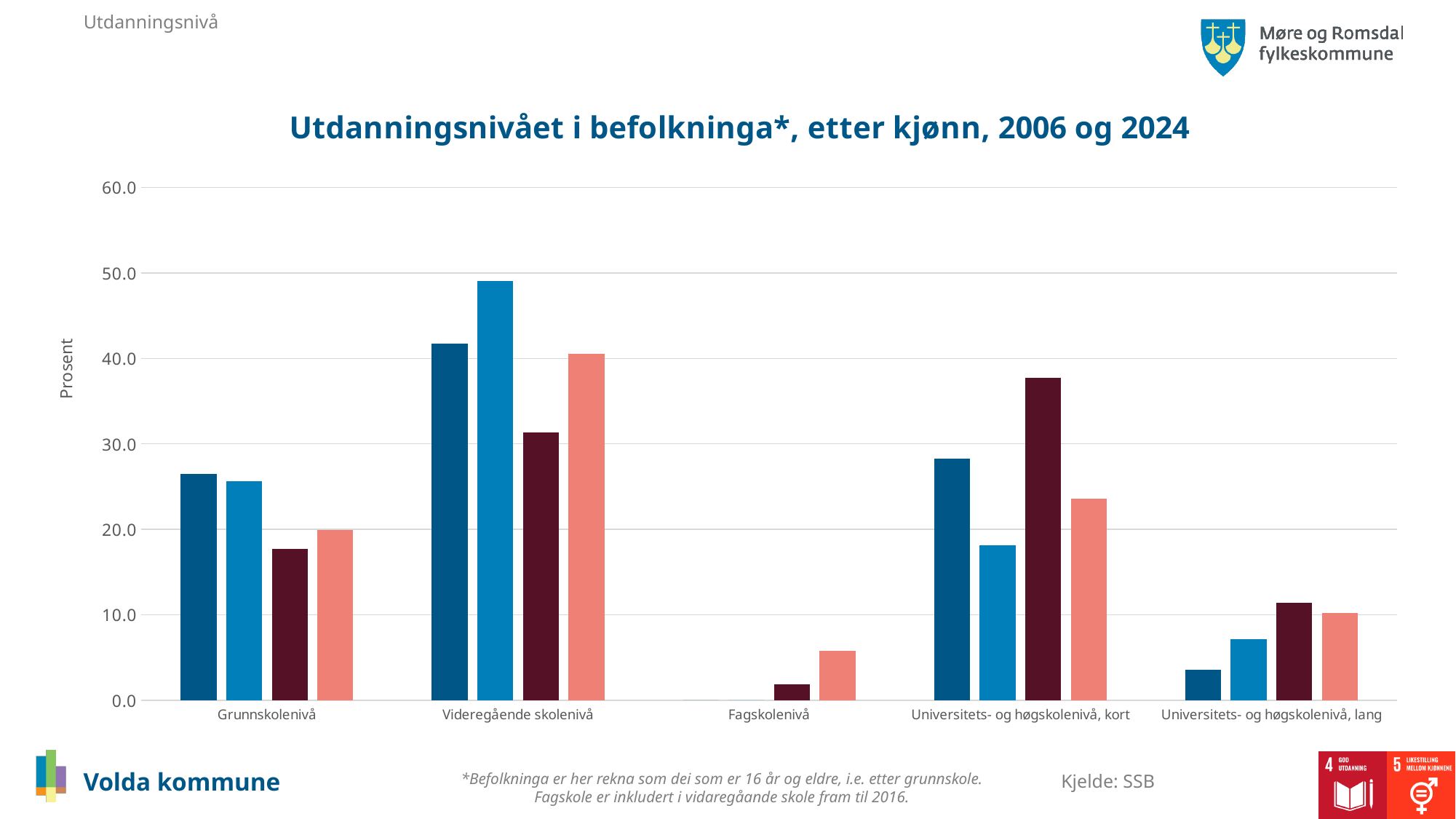
What kind of chart is shown on the slide? bar chart Is the salmon-coloured bar for Fagskolenivå greater or less than 10? less For Universitets- og høgskolenivå, lang, which is larger: the light blue bar or the dark red bar? the dark red bar Is the dark blue bar for Videregående skolenivå greater or less than 40? greater What is the title of the chart? Utdanningsnivået i befolkninga*, etter kjønn, 2006 og 2024 For Universitets- og høgskolenivå, kort, which is larger: the dark blue bar or the salmon-coloured bar? the dark blue bar Is the light blue bar for Universitets- og høgskolenivå, kort greater or less than 20? less How many education-level categories are shown along the x axis? 5 Which category has the lowest bars overall in the chart? Fagskolenivå Which category contains the tallest bar in the chart? Videregående skolenivå What is the label on the vertical axis of the chart? Prosent